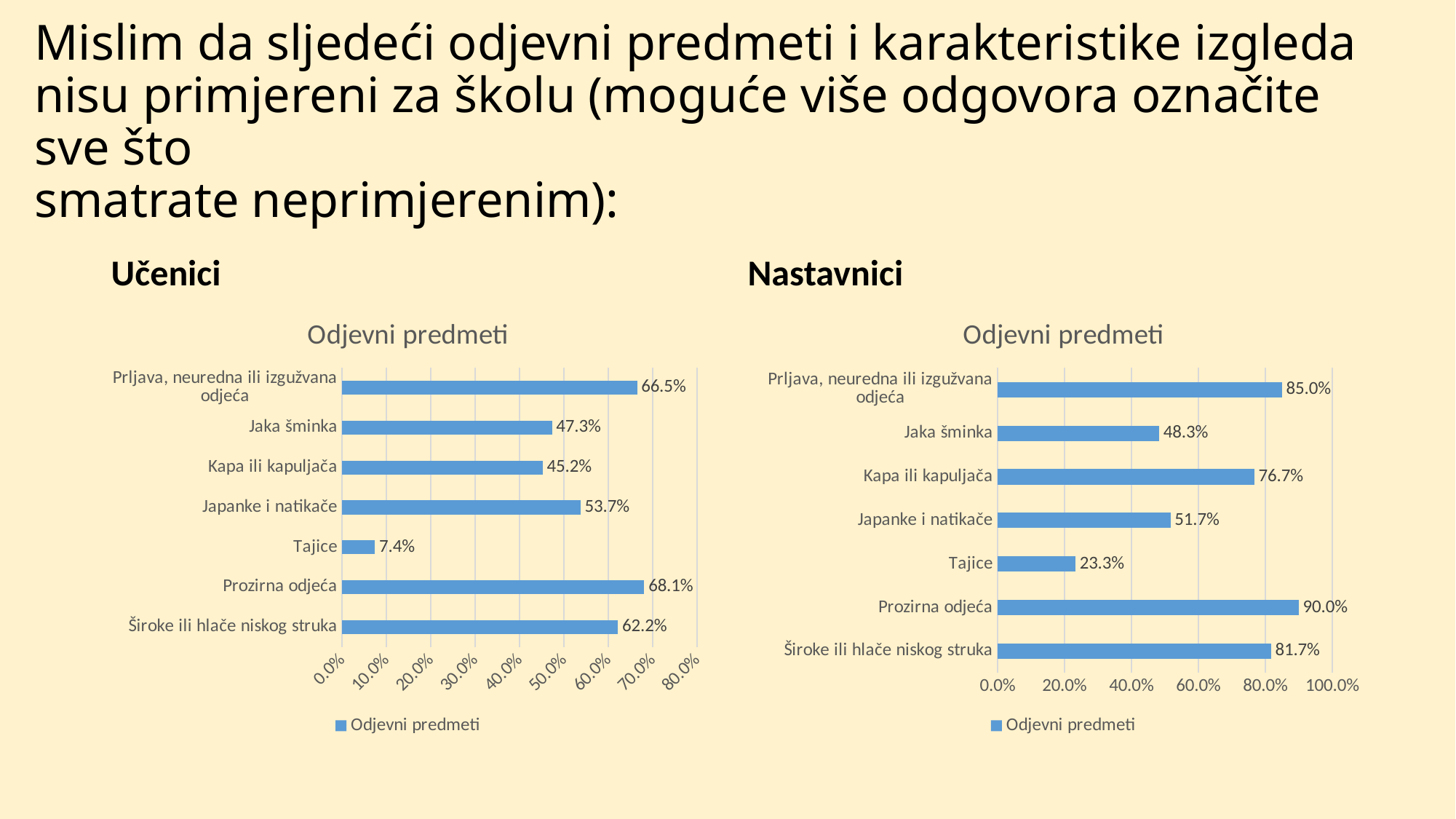
In the left chart (Učenici), which category has the highest value? Prozirna odjeća In the right chart (Nastavnici), what is the difference between Prozirna odjeća and Prljava, neuredna ili izgužvana odjeća? 5.0% What is the title of the right chart (Nastavnici)? Odjevni predmeti In the right chart (Nastavnici), which category has the lowest value? Tajice In the left chart (Učenici), what is the value for Tajice? 7.4% How many categories are shown in the right chart (Nastavnici)? 7 In the left chart (Učenici), which is larger: Jaka šminka or Kapa ili kapuljača? Jaka šminka In the right chart (Nastavnici), what is the value for Kapa ili kapuljača? 76.7% In the left chart (Učenici), what is the difference between Prozirna odjeća and Tajice? 60.7% What type of chart is the left chart (Učenici)? Bar chart In the left chart (Učenici), is the value for Japanke i natikače greater or less than 50.0%? greater How many series does the legend of the left chart (Učenici) list? 1